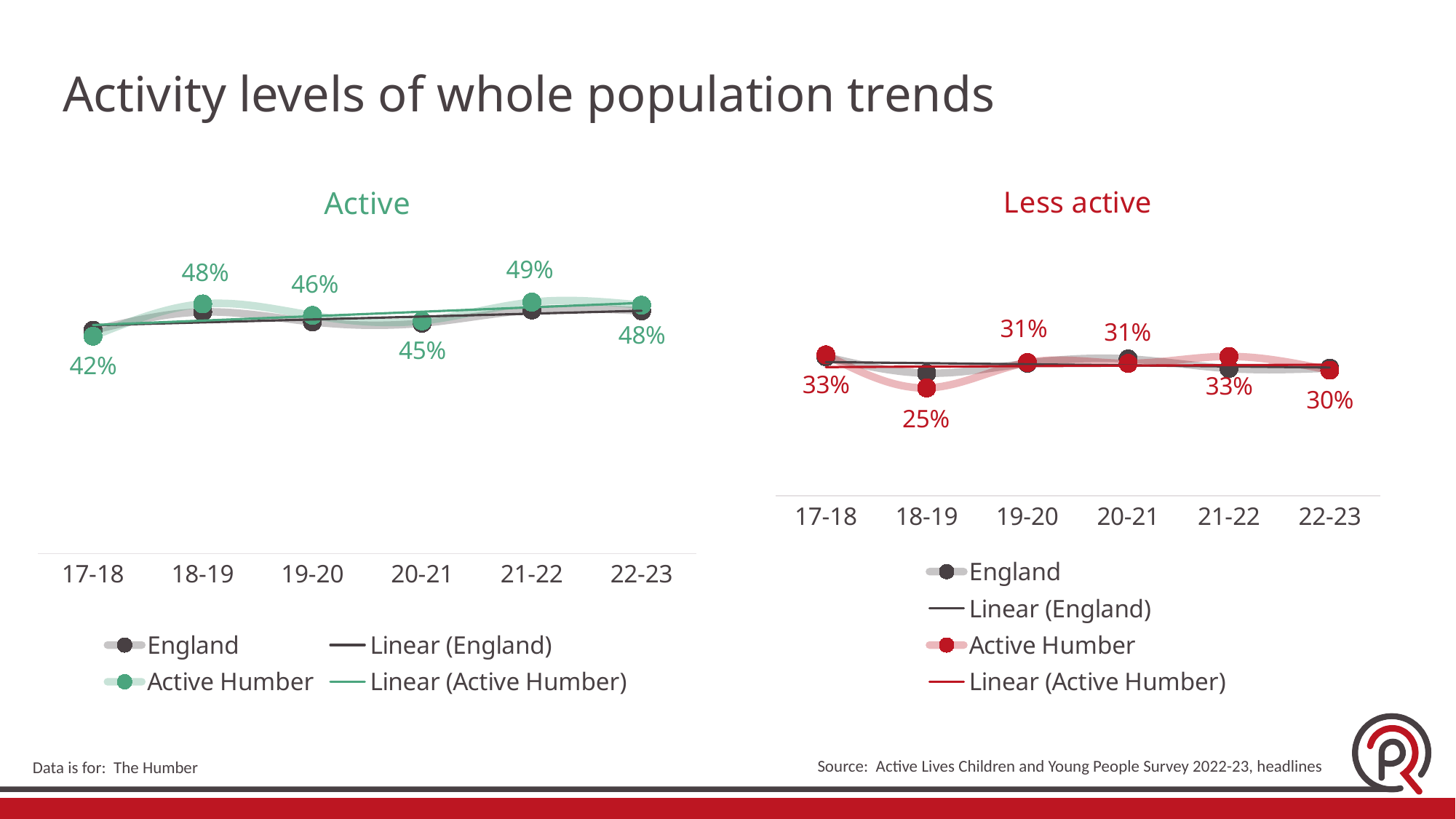
In the Active chart, what is the Active Humber value for 21-22? 49% In the Active chart, in which year is the Active Humber value lowest? 17-18 In the Less active chart, what is the Active Humber value for 18-19? 25% In the Less active chart, in which year is the Active Humber value lowest? 18-19 In the Active chart, in which year does Active Humber reach its highest value? 21-22 How many years are shown on the x axis of the Active chart? 6 In the Active chart, what is the Active Humber value for 17-18? 42% In the Less active chart, what is the Active Humber value for 22-23? 30% How many entries does the legend of the Less active chart list? 4 In the Less active chart, which is larger for Active Humber: the 17-18 value or the 18-19 value? 17-18 In the Active chart, what is the difference between the Active Humber values for 18-19 and 17-18? 6 percentage points What kind of chart is the Active chart? Line chart